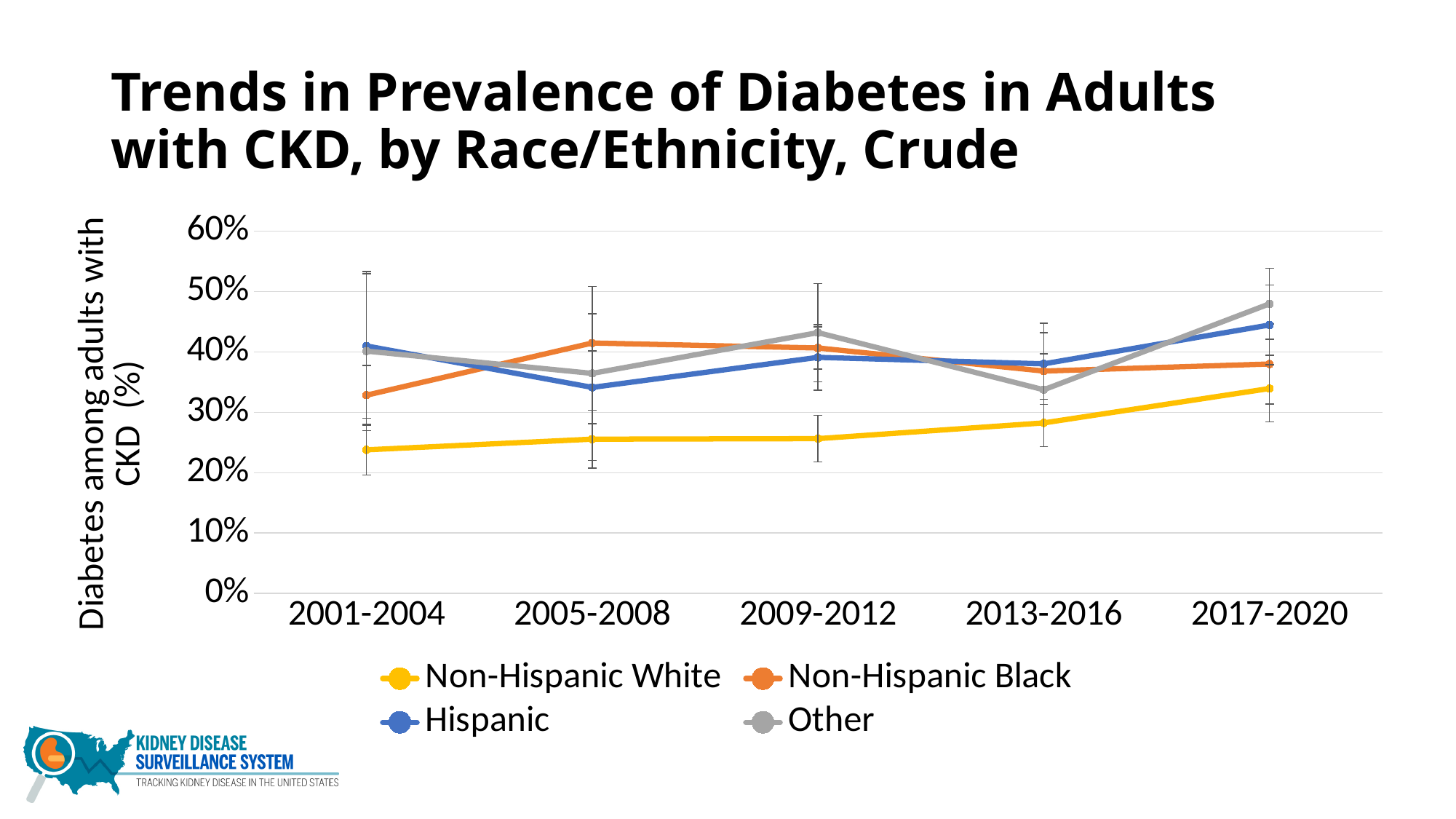
Is the value for Hispanic in 2005-2008 greater or less than 40%? less How many series does the legend list? 4 Which race/ethnicity group has the highest diabetes prevalence in 2005-2008? Non-Hispanic Black Which race/ethnicity group has the lowest diabetes prevalence in 2013-2016? Non-Hispanic White How many time periods are shown on the x axis? 5 Is the value for Non-Hispanic White in 2001-2004 greater or less than 30%? less Is the value for Other in 2017-2020 greater or less than 40%? greater What is the label on the y axis? Diabetes among adults with CKD (%) Does the Non-Hispanic White line rise or fall from 2001-2004 to 2017-2020? Rises What kind of chart is shown on the slide? Line chart In 2013-2016, which is higher: Hispanic or Other? Hispanic Which race/ethnicity group has the highest diabetes prevalence in 2017-2020? Other